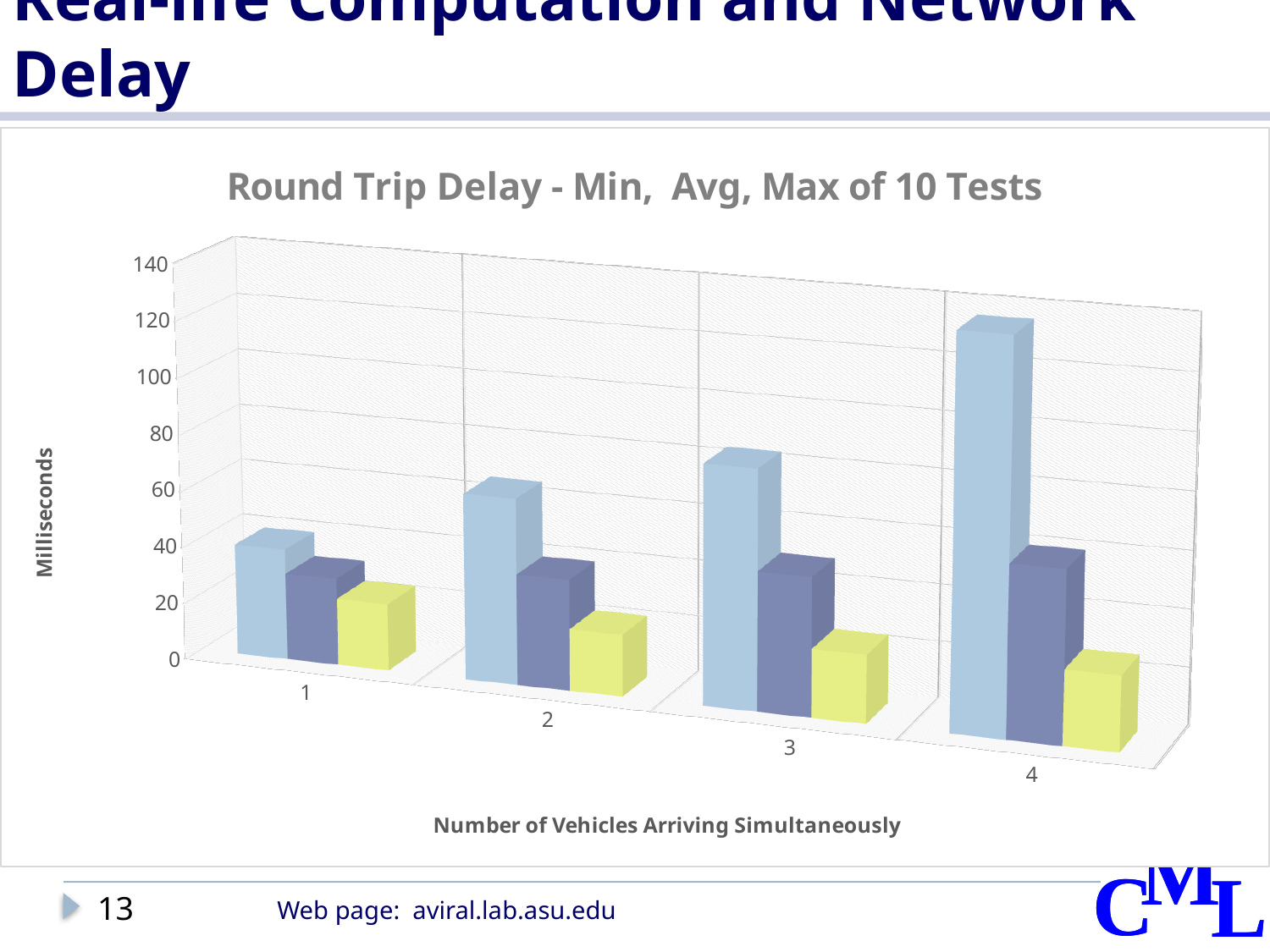
Is the value of the light blue bar for 1 vehicle greater or less than 60? less Is the value of the light blue bar for 3 vehicles greater or less than 40? greater How many bars are plotted for each category on the chart? 3 What is the label on the vertical axis of the chart? Milliseconds Which is larger: the light blue bar for 4 vehicles or the light blue bar for 1 vehicle? 4 vehicles Do the light blue bars rise or fall as the number of vehicles arriving simultaneously increases from 1 to 4? rise What is the title of the chart? Round Trip Delay - Min, Avg, Max of 10 Tests For 4 vehicles, which bar is taller: the light blue bar or the yellow bar? light blue How many categories are shown on the x axis of the chart? 4 For which number of vehicles is the light blue bar the tallest? 4 Is the value of the light blue bar for 4 vehicles greater or less than 100? greater What kind of chart is shown on the slide? bar chart